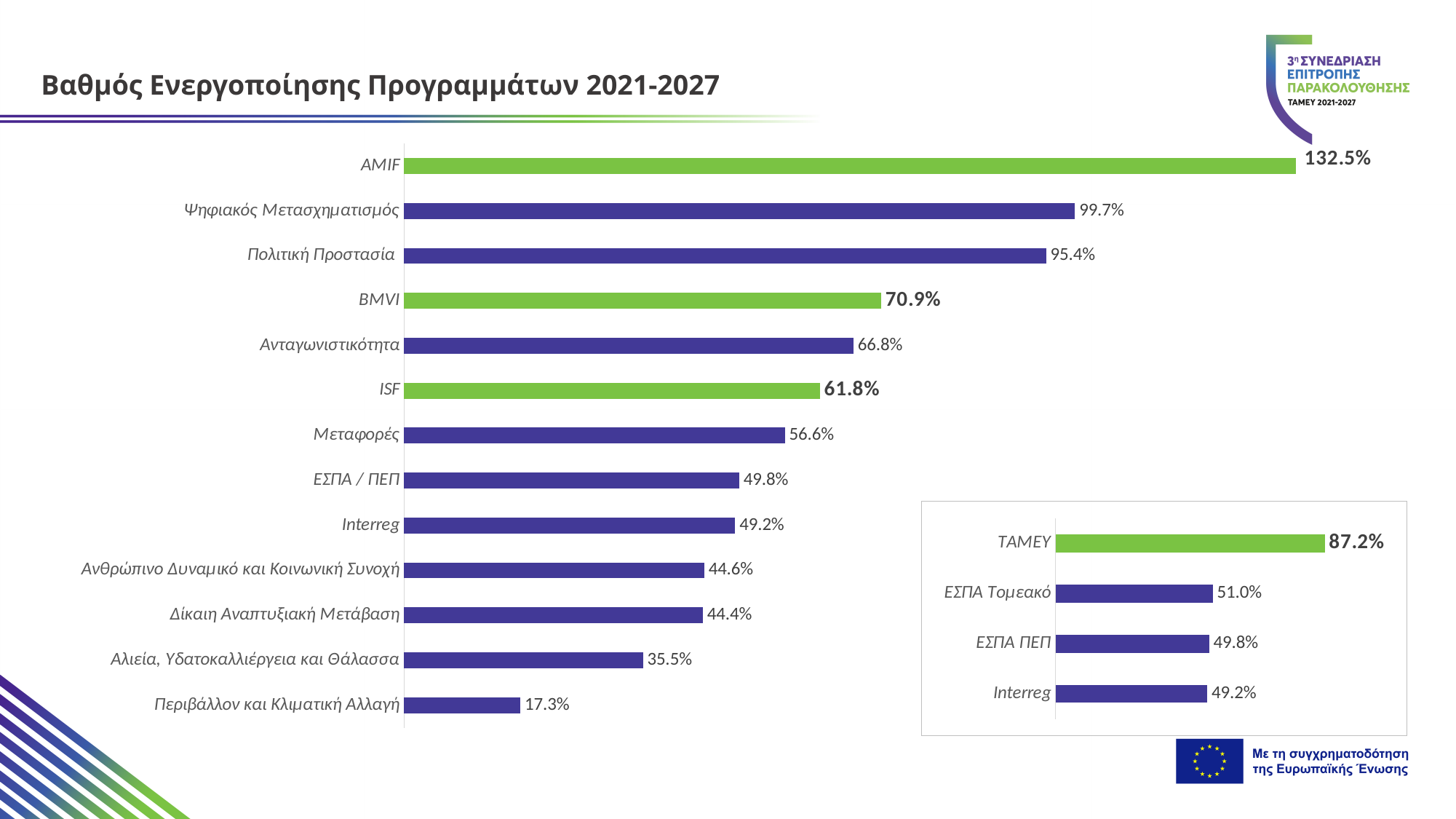
How many categories are shown in the large chart on the left? 13 In the small chart on the lower right, what is the difference between the values for ΤΑΜΕΥ and Interreg? 38.0% In the large chart on the left, which category has the highest value? AMIF In the small chart on the lower right, what is the value for ΤΑΜΕΥ? 87.2% In the large chart on the left, what is the difference between the values for BMVI and ISF? 9.1% In the large chart on the left, what is the value for Μεταφορές? 56.6% How many categories are shown in the small chart on the lower right? 4 In the small chart on the lower right, what is the value for ΕΣΠΑ Τομεακό? 51.0% In the large chart on the left, what is the value for AMIF? 132.5% What type of chart is the large chart on the left? Bar chart In the large chart on the left, which category has the lowest value? Περιβάλλον και Κλιματική Αλλαγή In the large chart on the left, which is larger: the value for Πολιτική Προστασία or the value for Ανταγωνιστικότητα? Πολιτική Προστασία